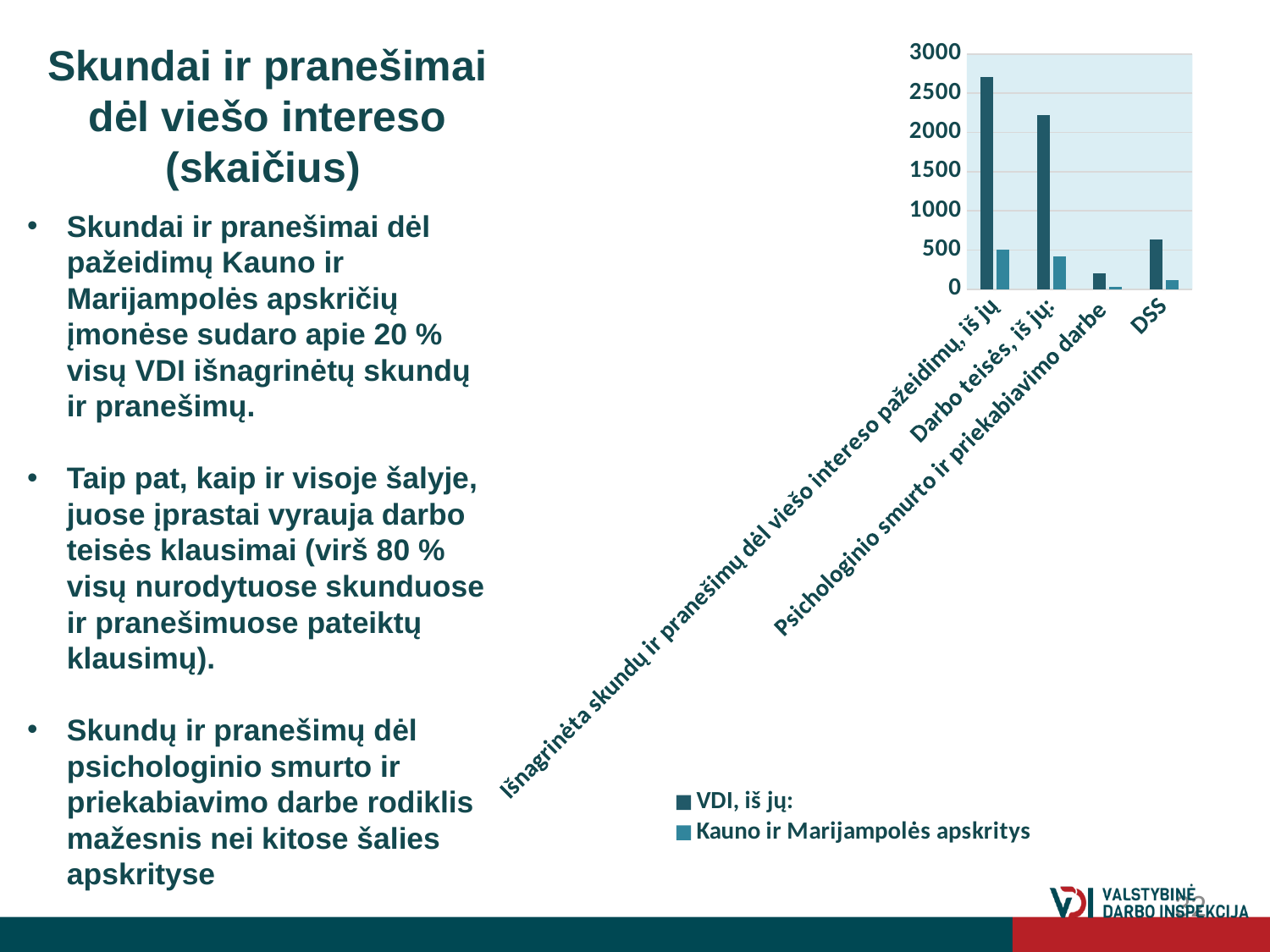
Is the 'VDI, iš jų:' value for 'Darbo teisės, iš jų:' greater or less than 2000? greater How many series does the chart legend list? 2 For the 'VDI, iš jų:' series, which is larger: the value for 'DSS' or the value for 'Psichologinio smurto ir priekabiavimo darbe'? DSS Is the 'VDI, iš jų:' value for 'DSS' greater or less than 500? greater Which category has the highest value for the 'VDI, iš jų:' series? Išnagrinėta skundų ir pranešimų dėl viešo intereso pažeidimų, iš jų How many categories are shown on the x axis of the chart? 4 What kind of chart is shown on the slide? bar chart Is the 'Kauno ir Marijampolės apskritys' value for 'Išnagrinėta skundų ir pranešimų dėl viešo intereso pažeidimų, iš jų' greater or less than 1000? less Which category has the lowest value for the 'VDI, iš jų:' series? Psichologinio smurto ir priekabiavimo darbe What are the two series names listed in the chart legend? VDI, iš jų: and Kauno ir Marijampolės apskritys